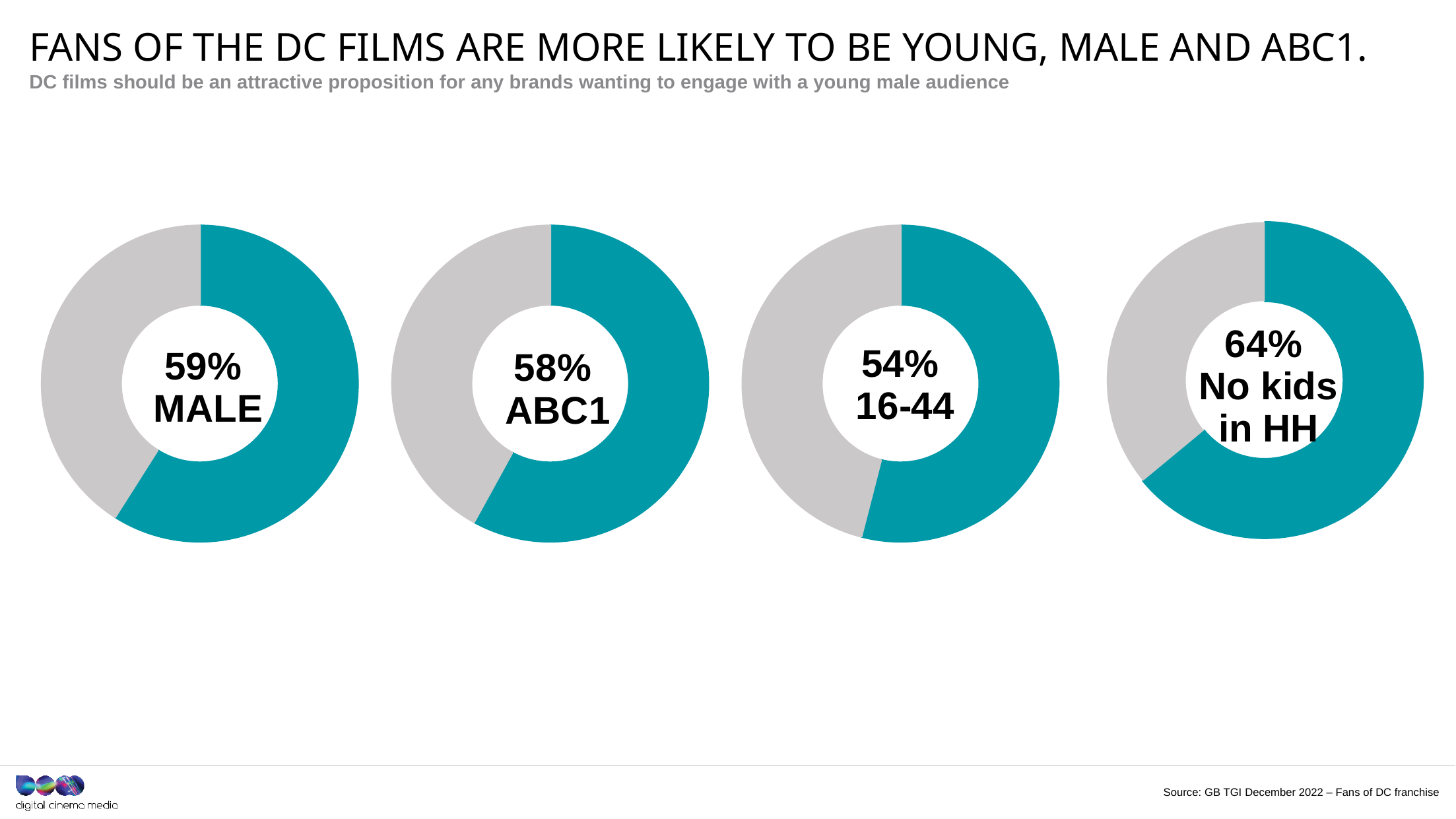
What percentage of DC film fans are aged 16-44, according to the third donut chart? 54% What is the difference in percentage points between the 'No kids in HH' chart and the '16-44' chart? 10 percentage points What percentage of DC film fans are male, according to the first donut chart? 59% What is the difference in percentage points between the 'MALE' chart and the 'ABC1' chart? 1 percentage point How many donut charts are shown on the slide? 4 What percentage of DC film fans have no kids in the household, according to the fourth donut chart? 64% What colour is used for the highlighted share in each donut chart? Teal Which is larger: the percentage for MALE or the percentage for 16-44? MALE Which of the four donut charts shows the lowest percentage? 16-44 (54%) What percentage of DC film fans are ABC1, according to the second donut chart? 58% What type of chart is used to show the percentages on this slide? Donut (pie) chart Which of the four donut charts shows the highest percentage? No kids in HH (64%)